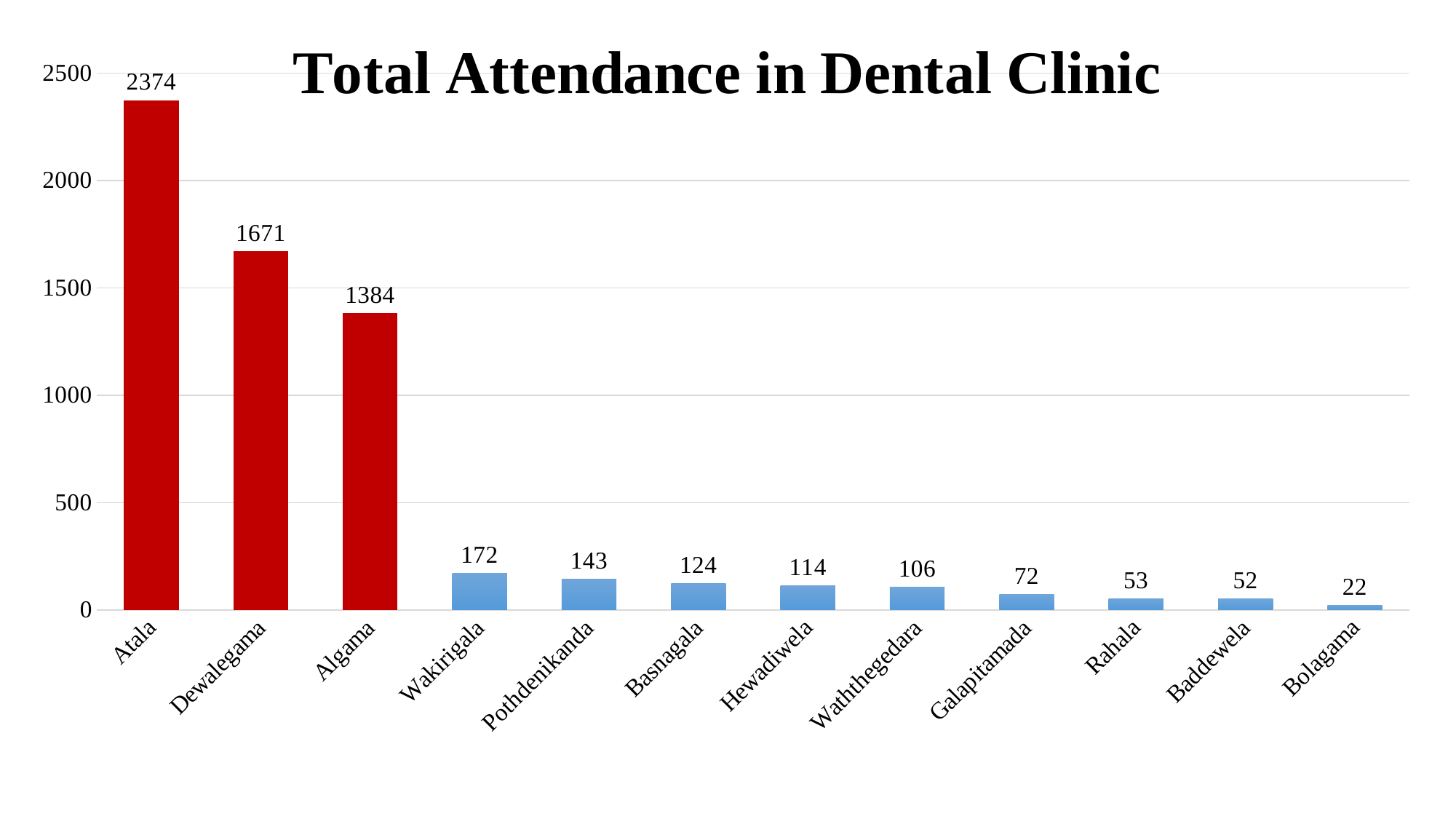
What is the difference in attendance between Atala and Dewalegama? 703 What is the total attendance for Bolagama? 22 What is the difference in attendance between Wakirigala and Basnagala? 48 Is the value for Algama greater or less than 1500? less What kind of chart is shown on the slide? Bar chart How many clinics are shown on the chart? 12 What is the title of the chart? Total Attendance in Dental Clinic Which clinic has the lowest total attendance? Bolagama What is the total attendance for Pothdenikanda? 143 What is the total attendance for Atala? 2374 Which has higher attendance, Algama or Dewalegama? Dewalegama Which clinic has the highest total attendance? Atala